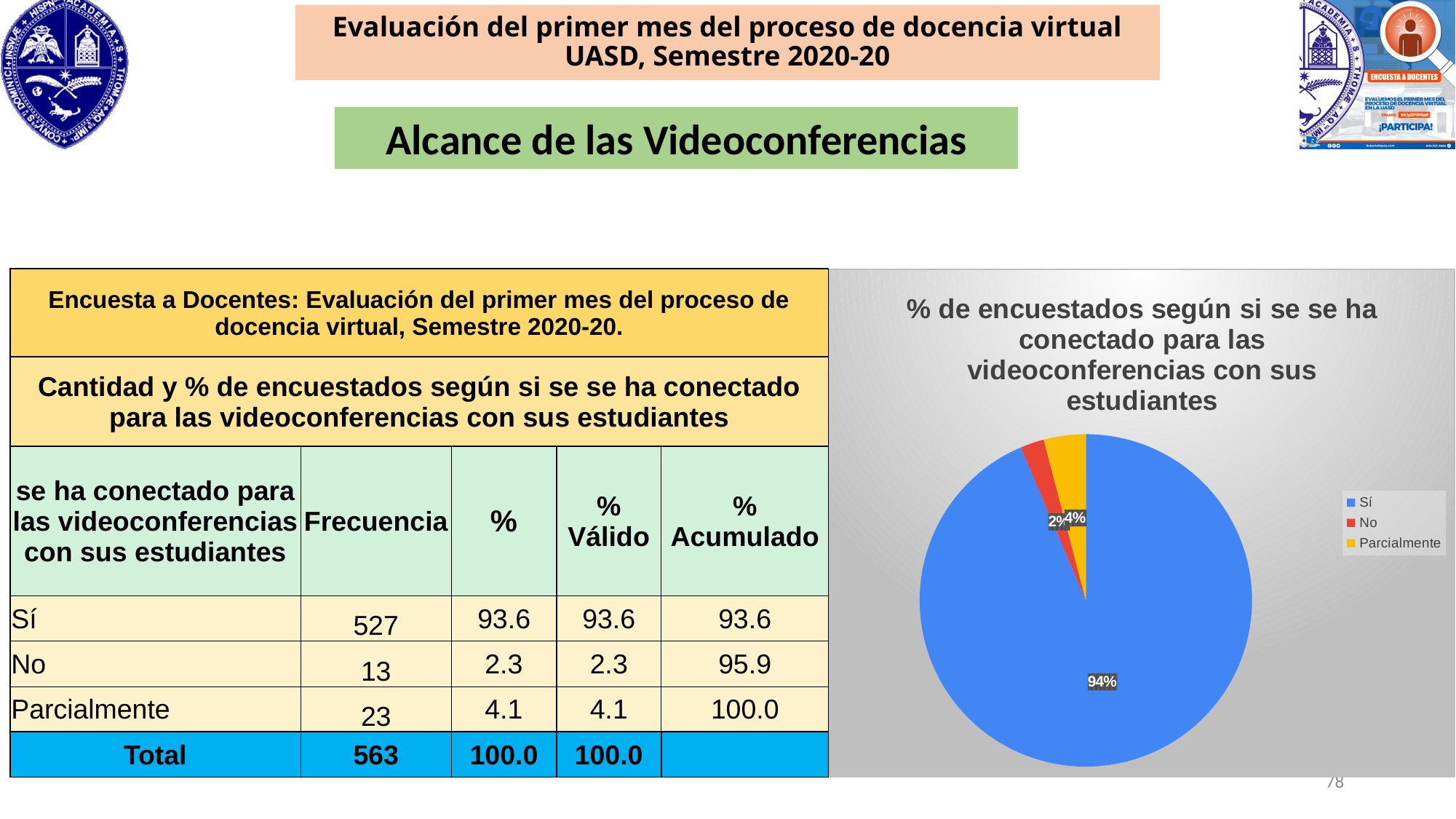
What percentage does the pie chart show for "Parcialmente"? 4% What kind of chart is shown on the slide? pie chart Which category has the smallest slice in the pie chart? No What colour is the "Parcialmente" slice in the pie chart? yellow What colour is the "Sí" slice in the pie chart? blue How many categories does the pie chart's legend list? 3 What is the difference in percentage points between the "Sí" slice and the "Parcialmente" slice in the pie chart? 90% Which category has the largest slice in the pie chart? Sí What percentage does the pie chart show for "Sí"? 94% What percentage does the pie chart show for "No"? 2% In the pie chart, which is larger: the slice for "No" or the slice for "Parcialmente"? Parcialmente